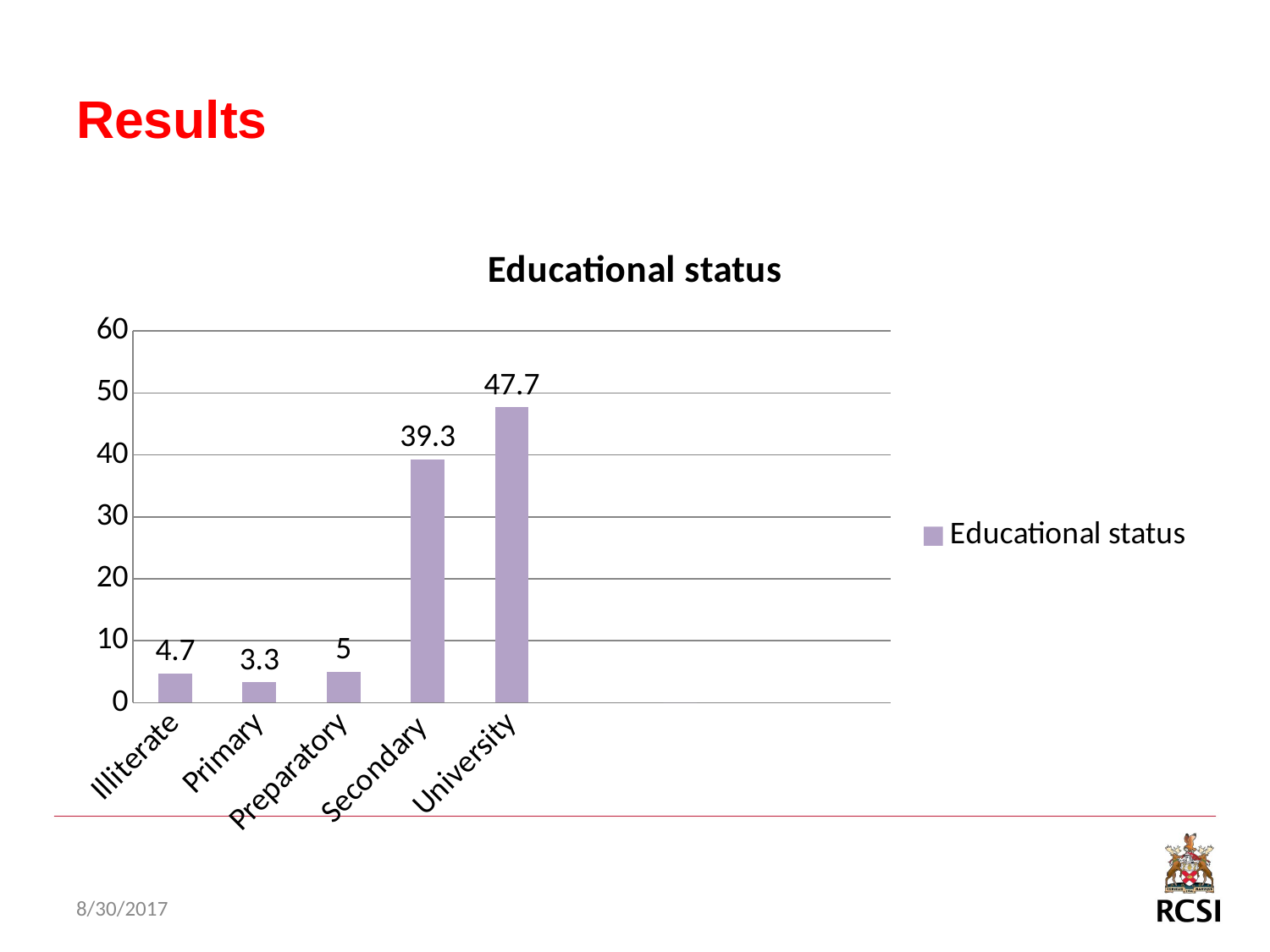
How many categories are shown on the x axis of the Educational status chart? 5 Which is larger, the value for Illiterate or the value for Primary? Illiterate What kind of chart is shown on the slide? bar chart What is the value for University in the Educational status chart? 47.7 What is the value for Preparatory in the Educational status chart? 5 What is the value for Illiterate in the Educational status chart? 4.7 Which category has the highest value in the Educational status chart? University What is the title of the chart on the slide? Educational status What is the value for Secondary in the Educational status chart? 39.3 Which category has the lowest value in the Educational status chart? Primary What is the difference between the values for University and Secondary? 8.4 Is the value for Secondary greater or less than 30? greater